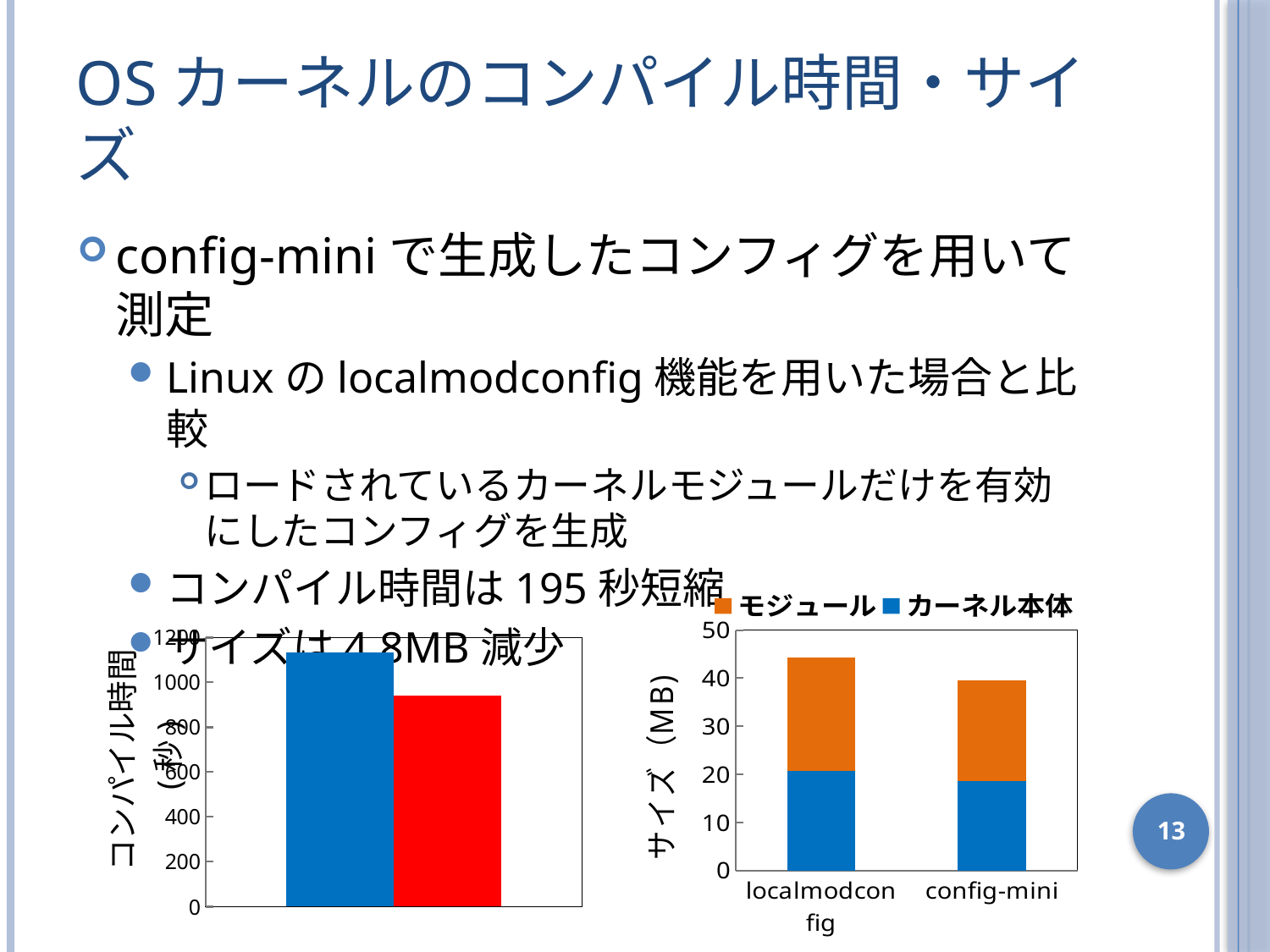
In the right-hand chart (サイズ (MB)), which category has the taller stacked bar, localmodconfig or config-mini? localmodconfig In the right-hand chart (サイズ (MB)), how many series does the legend list? 2 In the left-hand chart (コンパイル時間 (秒)), how many bars are plotted? 2 What kind of chart is the right-hand chart (サイズ (MB))? stacked bar chart In the right-hand chart (サイズ (MB)), is the total stacked value for localmodconfig greater or less than 40? greater In the right-hand chart (サイズ (MB)), is the カーネル本体 value for config-mini greater or less than 20? less In the right-hand chart (サイズ (MB)), how many categories are shown on the x axis? 2 What kind of chart is the left-hand chart (コンパイル時間 (秒))? bar chart In the left-hand chart (コンパイル時間 (秒)), is the value of the red bar greater or less than 1000? less In the right-hand chart (サイズ (MB)), which legend entry is shown in orange? モジュール